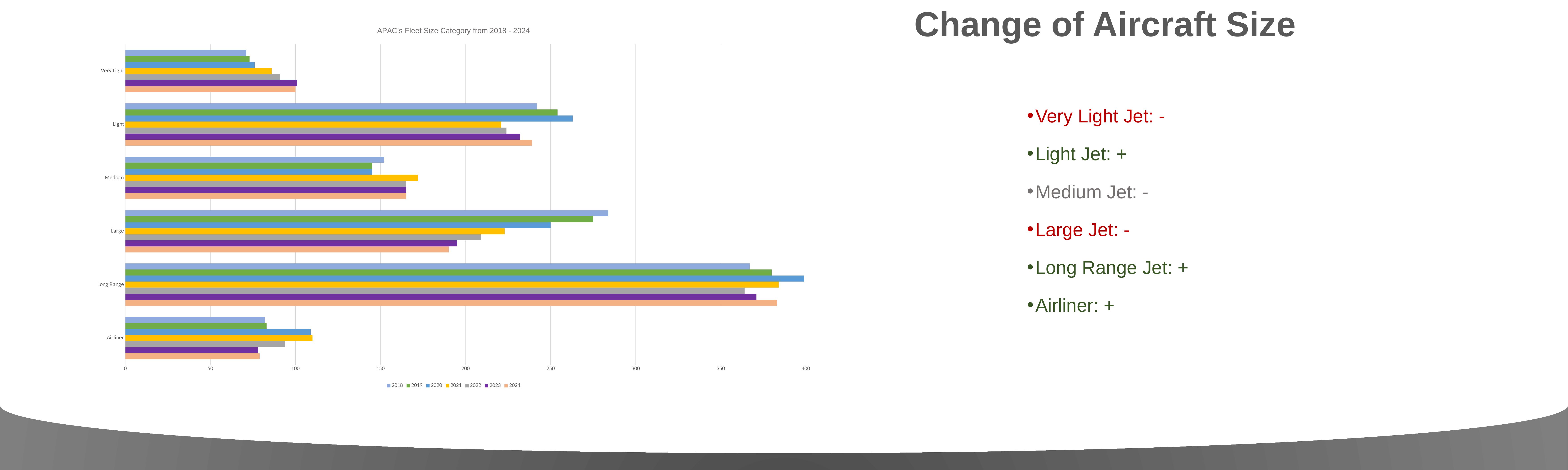
Is the value for Large in 2024 greater or less than 200? less Is the value for Long Range in 2020 greater or less than 350? greater Which is larger, the 2020 value for Light or the 2020 value for Medium? Light What is the title of the chart? APAC's Fleet Size Category from 2018 - 2024 How many fleet size categories are shown on the chart? 6 Is the value for Light in 2020 greater or less than 250? greater Which fleet size category has the smallest values across the years? Very Light Which fleet size category has the largest values across the years? Long Range Which is larger for the Large category, the 2018 value or the 2024 value? 2018 How many series does the chart legend list? 7 What type of chart is shown on the slide? Bar chart